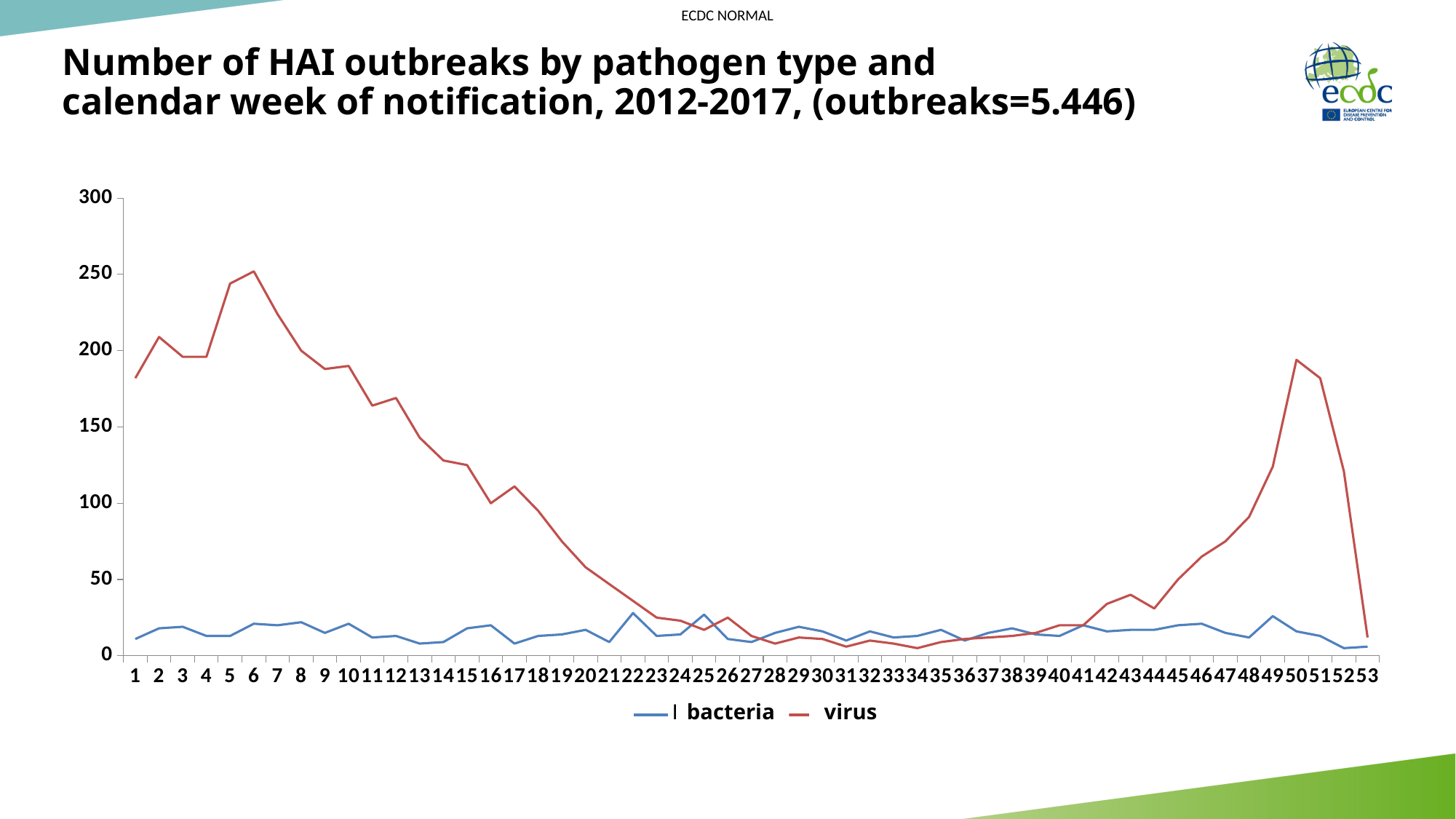
How many series does the legend list? 2 Is the value for bacteria in week 22 greater or less than 50? less How many calendar weeks are shown along the x axis? 53 Is the value for virus in week 30 greater or less than 50? less In week 6, which series has the larger value, bacteria or virus? virus Is the value for virus in week 6 greater or less than 200? greater What colour is the line for the virus series? red In which calendar week does the virus series reach its highest value? 6 Does the virus series rise or fall between week 44 and week 50? rise What kind of chart is shown on the slide? line chart For the virus series, is the value in week 1 larger or the value in week 53? week 1 Does the virus series rise or fall between week 6 and week 30? fall